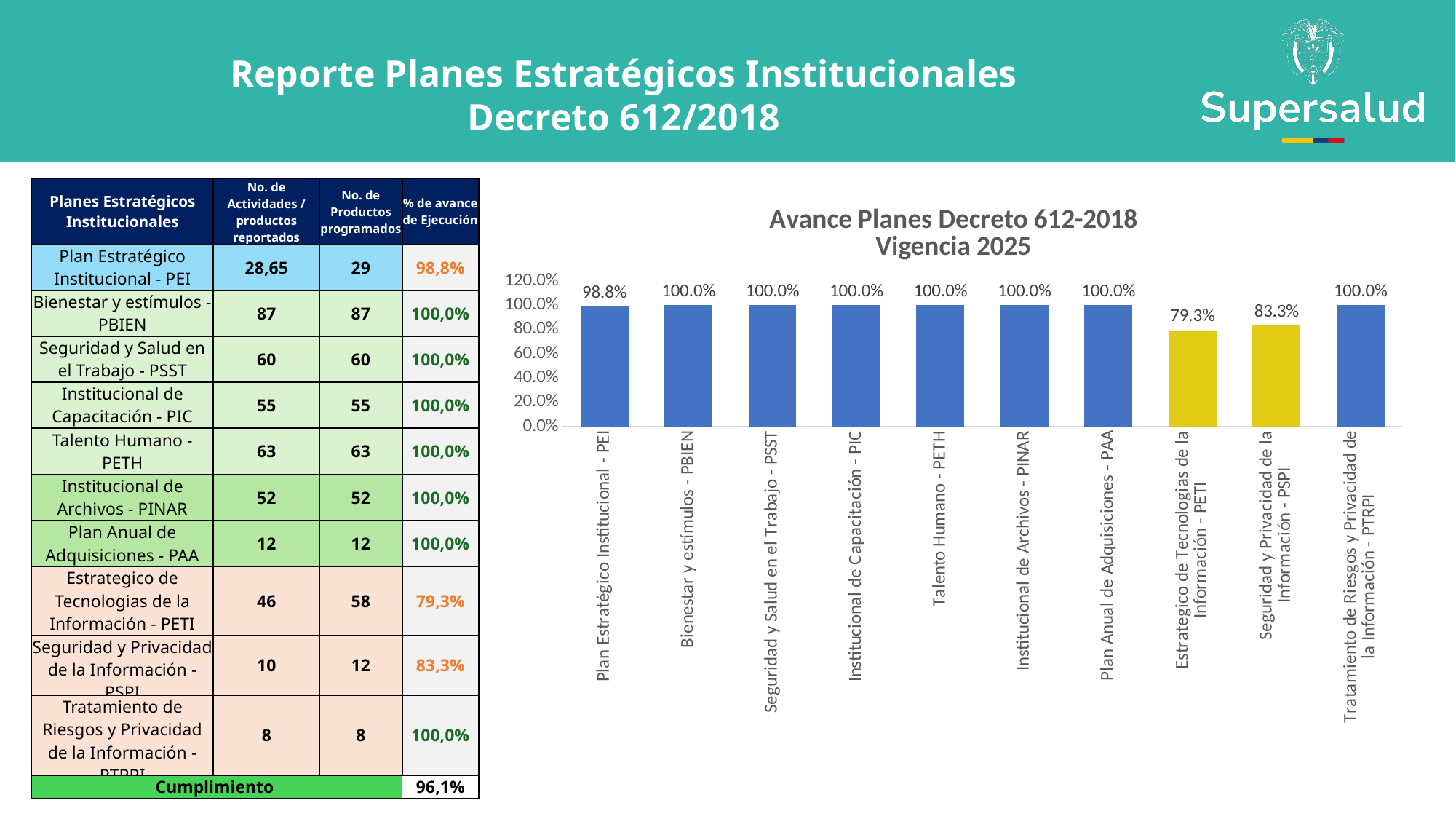
What is the difference between the values for Seguridad y Privacidad de la Información - PSPI and Estrategico de Tecnologias de la Información - PETI? 4.0 percentage points What is the value shown for Estrategico de Tecnologias de la Información - PETI? 79.3% Which is larger, the value for Plan Estratégico Institucional - PEI or the value for Seguridad y Privacidad de la Información - PSPI? Plan Estratégico Institucional - PEI What kind of chart is shown on the slide? Bar chart What is the value shown for Seguridad y Privacidad de la Información - PSPI? 83.3% What is the value shown for Plan Estratégico Institucional - PEI? 98.8% Which category has the lowest value in the chart? Estrategico de Tecnologias de la Información - PETI How many categories are plotted in the chart? 10 What is the title of the chart? Avance Planes Decreto 612-2018 Vigencia 2025 Is the value for Seguridad y Privacidad de la Información - PSPI greater or less than 60.0%? greater What is the difference between the values for Plan Estratégico Institucional - PEI and Estrategico de Tecnologias de la Información - PETI? 19.5 percentage points What is the value shown for Plan Anual de Adquisiciones - PAA? 100.0%